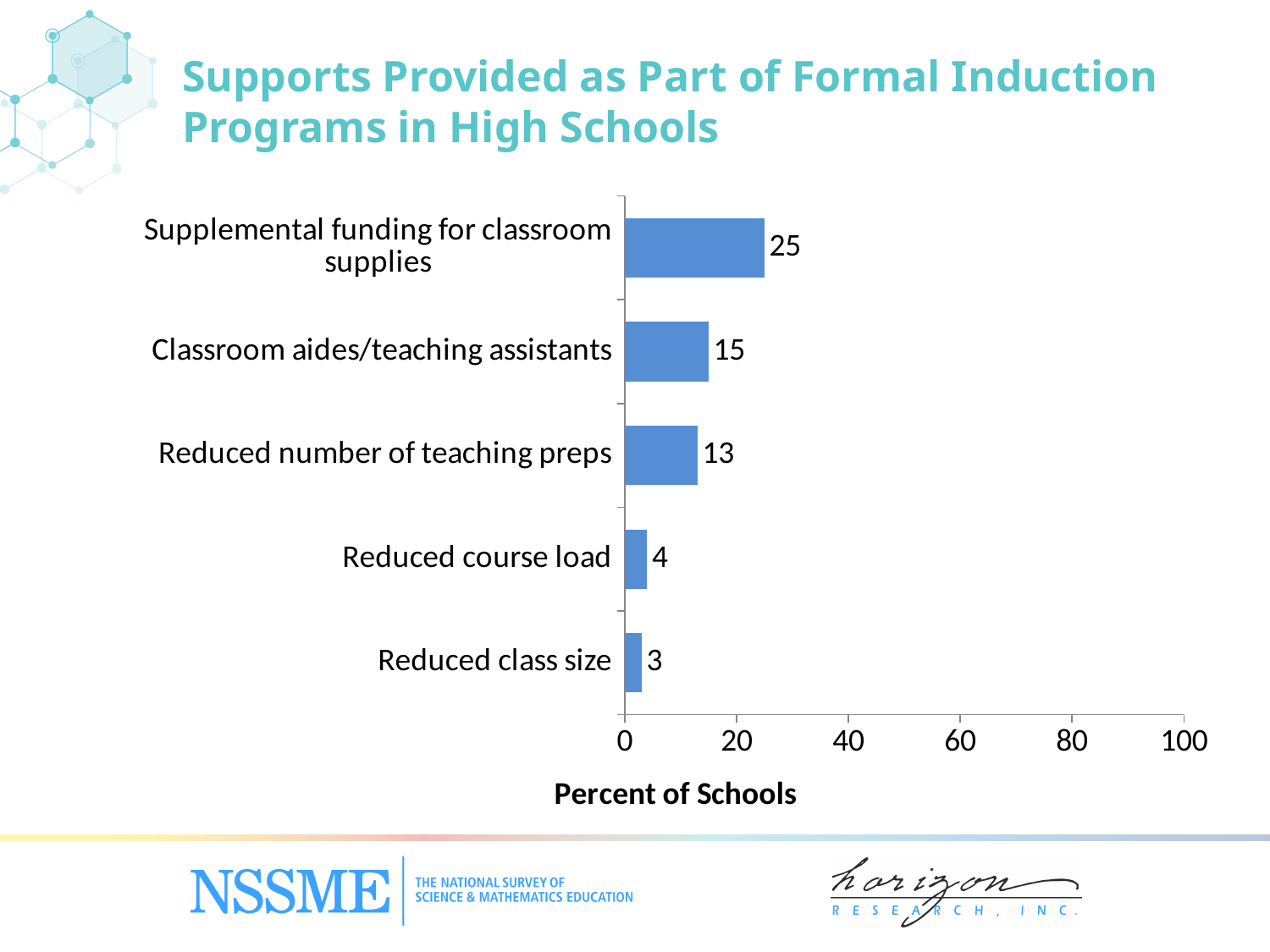
What is the value for Classroom aides/teaching assistants? 15 What is the value for Reduced class size? 3 Which support has the highest percent of schools? Supplemental funding for classroom supplies What percent of schools provide supplemental funding for classroom supplies as part of formal induction programs? 25 Which is larger, the value for Reduced course load or the value for Reduced number of teaching preps? Reduced number of teaching preps Which support has the lowest percent of schools? Reduced class size Is the value for Supplemental funding for classroom supplies greater or less than 40? less What is the value for Reduced number of teaching preps? 13 What kind of chart is shown on the slide? Bar chart What is the label of the horizontal axis? Percent of Schools How many supports are shown in the chart? 5 What is the difference between the values for Supplemental funding for classroom supplies and Classroom aides/teaching assistants? 10